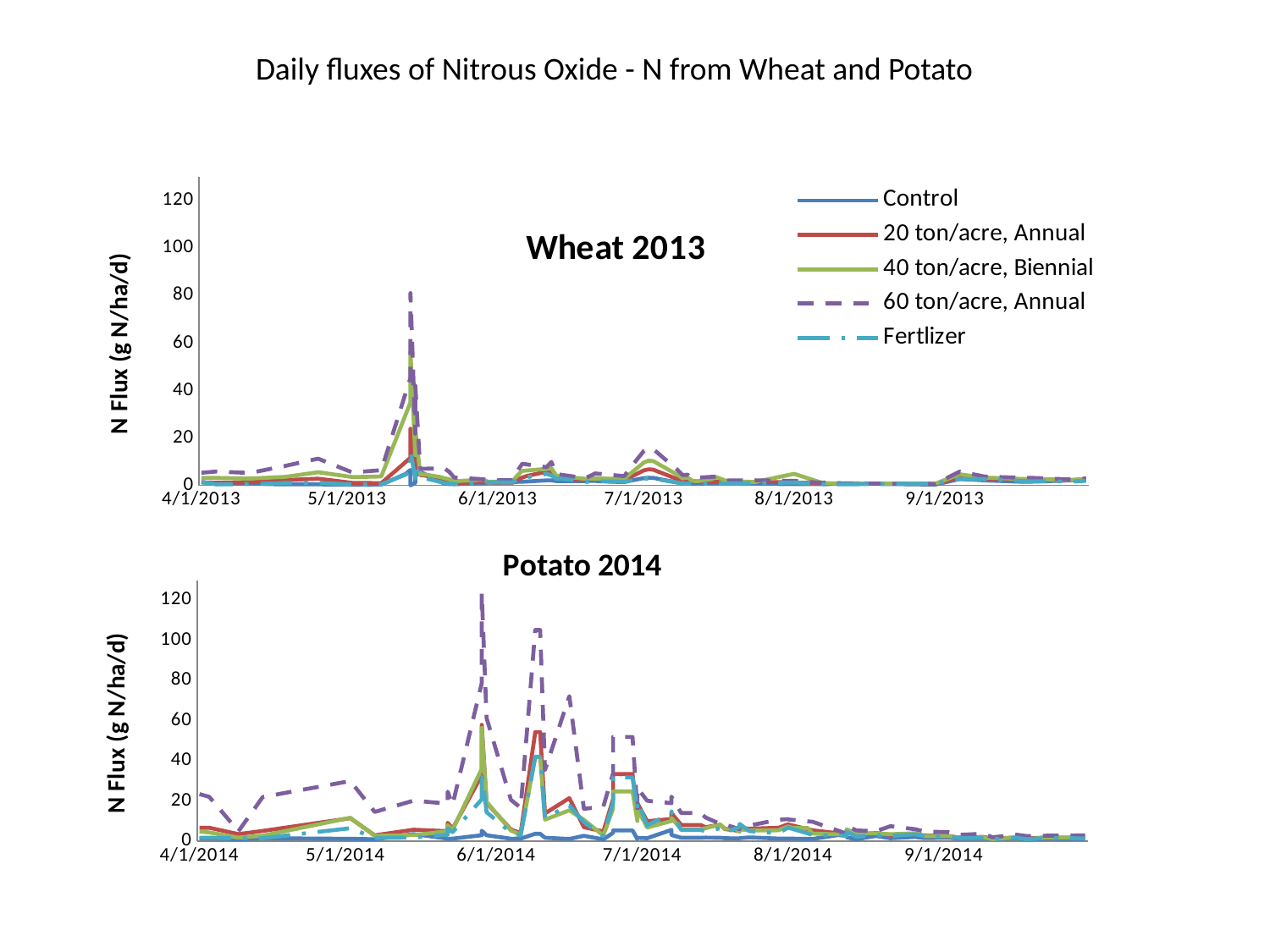
In the Potato 2014 chart, do the values of the 60 ton/acre, Annual series generally rise or fall between 7/1/2014 and 9/1/2014? fall How many series does the legend list for the charts on this slide? 5 In the Potato 2014 chart, is the peak value of the Control series greater or less than 20? less What is the title of the slide's overall chart heading? Daily fluxes of Nitrous Oxide - N from Wheat and Potato In the Wheat 2013 chart, is the peak value of the 60 ton/acre, Annual series greater or less than 60? greater In the Wheat 2013 chart, which series reaches the highest peak value? 60 ton/acre, Annual In the Wheat 2013 chart, is the peak value of the 60 ton/acre, Annual series greater or less than 100? less What kind of chart is the Wheat 2013 chart? line chart In the Potato 2014 chart, which series has a higher peak: 60 ton/acre, Annual or 20 ton/acre, Annual? 60 ton/acre, Annual What is the y-axis label on the Potato 2014 chart? N Flux (g N/ha/d) In the Potato 2014 chart, which series reaches the highest peak value? 60 ton/acre, Annual